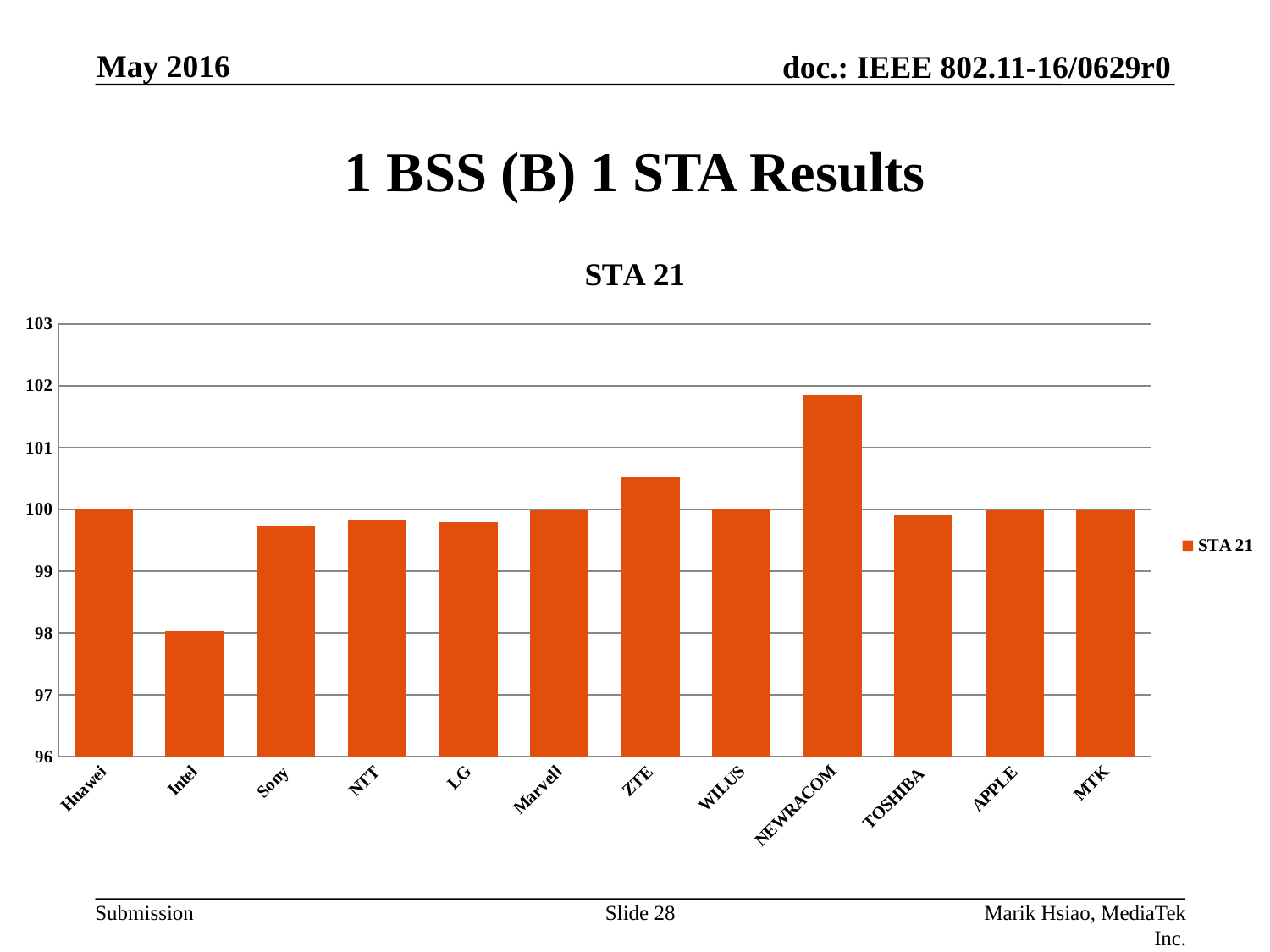
Is the value for NEWRACOM greater or less than 101? greater What kind of chart is shown on the slide? bar chart How many categories are shown on the x axis of the chart? 12 Which category has the highest value? NEWRACOM Is the value for ZTE greater or less than 100? greater Which is larger, the value for Intel or the value for TOSHIBA? TOSHIBA What is the title of the chart? STA 21 Which is larger, the value for ZTE or the value for Sony? ZTE Is the value for Intel greater or less than 99? less Which category has the lowest value? Intel How many series does the legend list? 1